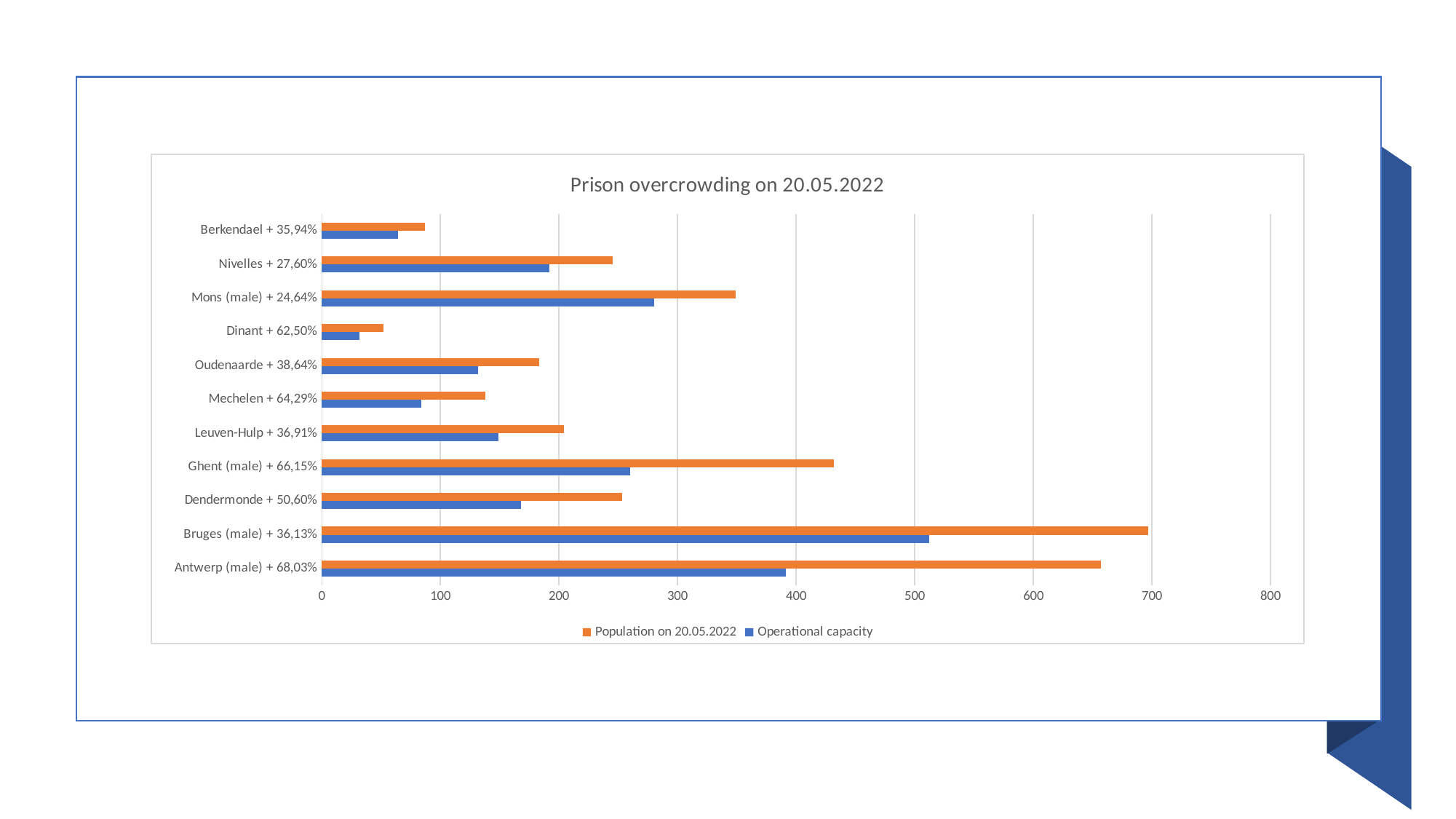
How many series does the legend list? 2 Which prison has the highest Population on 20.05.2022? Bruges (male) + 36,13% Is the Population on 20.05.2022 for Berkendael greater or less than 100? less Which colour represents the Operational capacity series? blue How many prisons (categories) are shown on the chart? 11 What is the title of the chart? Prison overcrowding on 20.05.2022 What kind of chart is shown on the slide? bar chart Is the Population on 20.05.2022 for Antwerp (male) greater or less than 600? greater Which is larger: the Population on 20.05.2022 for Ghent (male) or for Mons (male)? Ghent (male) Which prison has the lowest Population on 20.05.2022? Dinant + 62,50% Is the Operational capacity for Mons (male) greater or less than 300? less Which prison has the highest Operational capacity? Bruges (male) + 36,13%